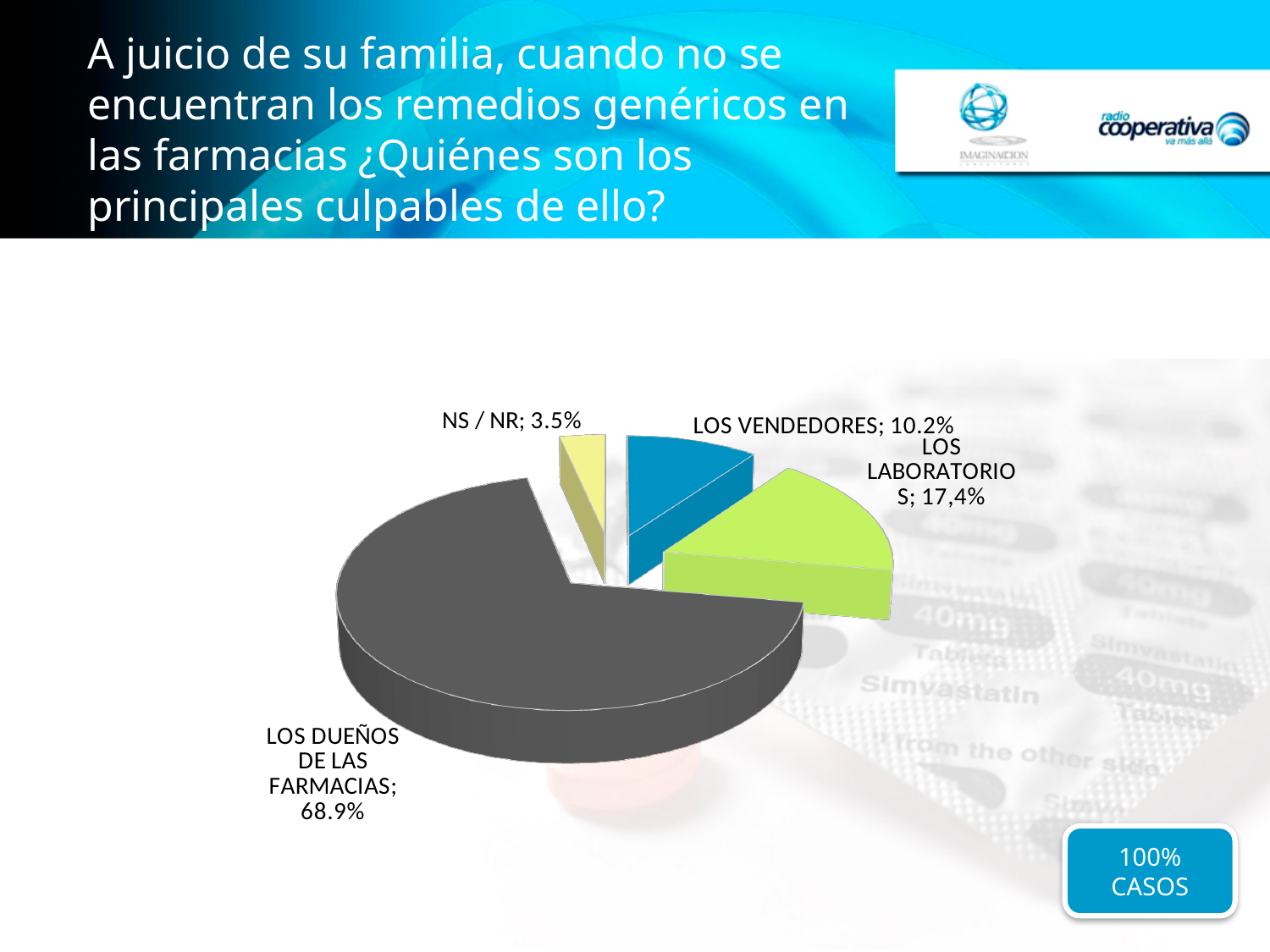
Which category has the smallest share of the pie? NS / NR What is the difference in percentage points between LOS VENDEDORES and NS / NR? 6.7 What colour is the slice for LOS DUEÑOS DE LAS FARMACIAS? dark grey How many slices does the pie chart have? 4 What percentage is shown for LOS DUEÑOS DE LAS FARMACIAS? 68.9% What percentage is shown for LOS VENDEDORES? 10.2% Which category has the largest share of the pie? LOS DUEÑOS DE LAS FARMACIAS What percentage is shown for LOS LABORATORIOS? 17,4% What percentage is shown for NS / NR? 3.5% Which is larger, the share for LOS LABORATORIOS or the share for LOS VENDEDORES? LOS LABORATORIOS What kind of chart is shown on the slide? pie chart What is the difference in percentage points between LOS DUEÑOS DE LAS FARMACIAS and LOS LABORATORIOS? 51.5